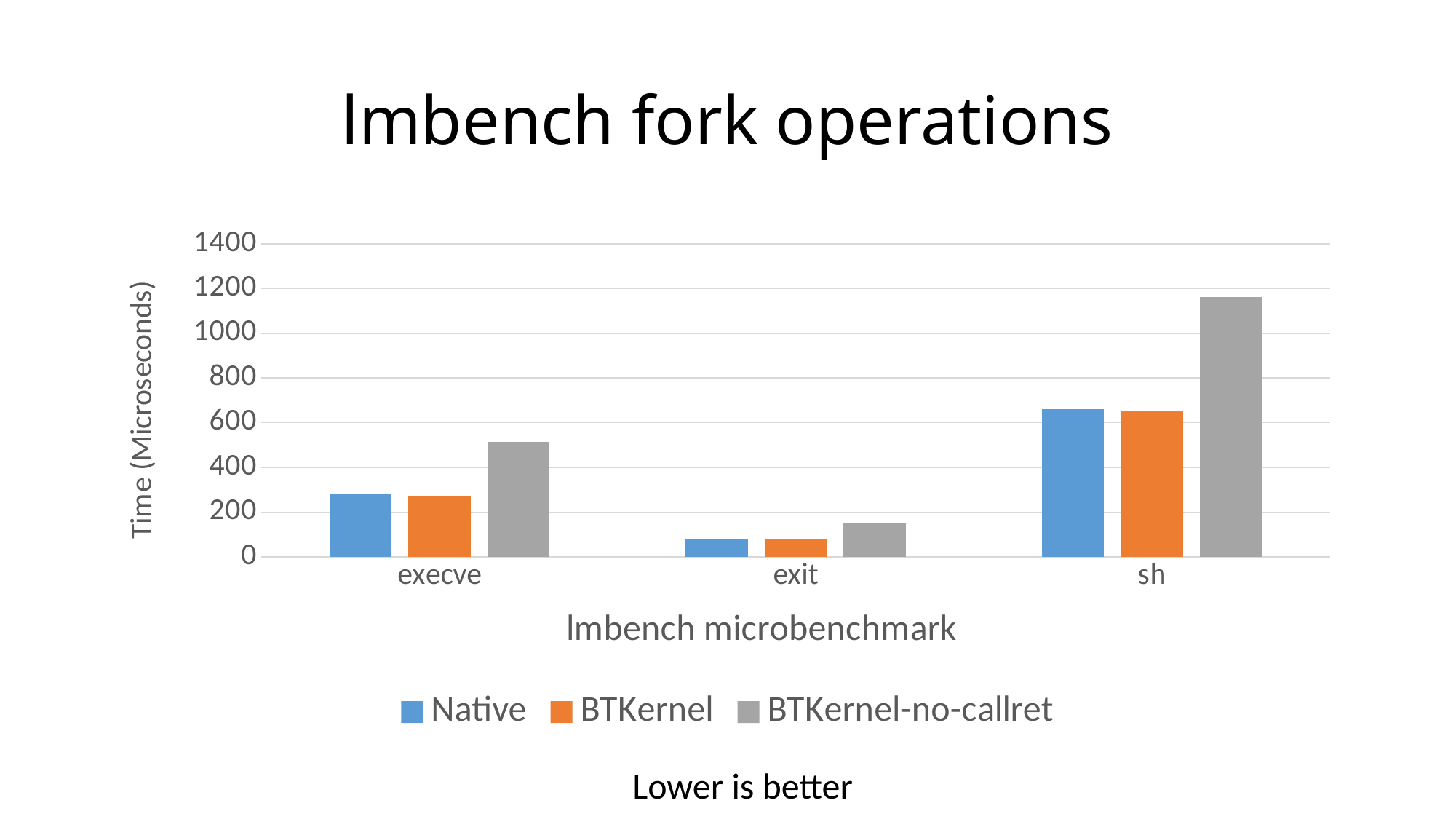
How many microbenchmark categories are shown on the x axis? 3 Is the BTKernel-no-callret value for sh greater or less than 1000? greater Is the BTKernel value for exit greater or less than 200? less Which series is shown in gray? BTKernel-no-callret Is the Native value for execve greater or less than 400? less What kind of chart is shown on the slide? bar chart For sh, which is larger: the BTKernel value or the BTKernel-no-callret value? BTKernel-no-callret What is the label of the y axis? Time (Microseconds) How many series does the legend list? 3 Which microbenchmark has the lowest Native time? exit Which microbenchmark has the highest BTKernel-no-callret time? sh